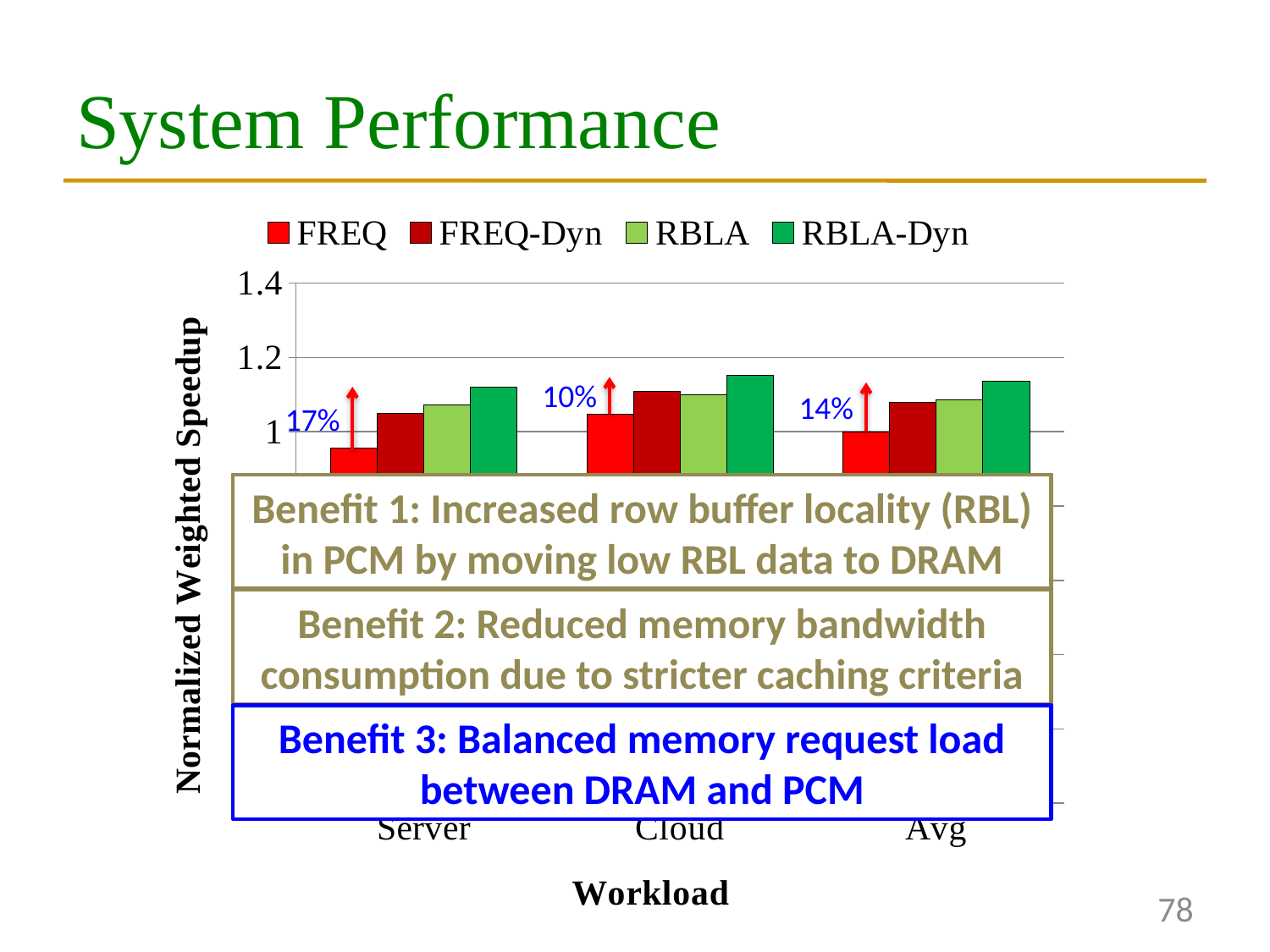
How many series does the legend list? 4 Is the RBLA-Dyn value for Cloud greater or less than 1.2? less What kind of chart is shown on the slide? bar chart For the Server workload, which is larger: the FREQ bar or the RBLA-Dyn bar? RBLA-Dyn Is the FREQ value for Server greater or less than 1? less Which series has the highest bar for the Server workload? RBLA-Dyn Is the FREQ-Dyn value for Server greater or less than 1? greater Which series has the lowest bar for the Avg workload? FREQ Which series has the lowest bar for the Server workload? FREQ What percentage improvement is annotated above the Avg workload group? 14% How many workload categories are shown on the x axis? 3 Which series has the highest bar for the Cloud workload? RBLA-Dyn